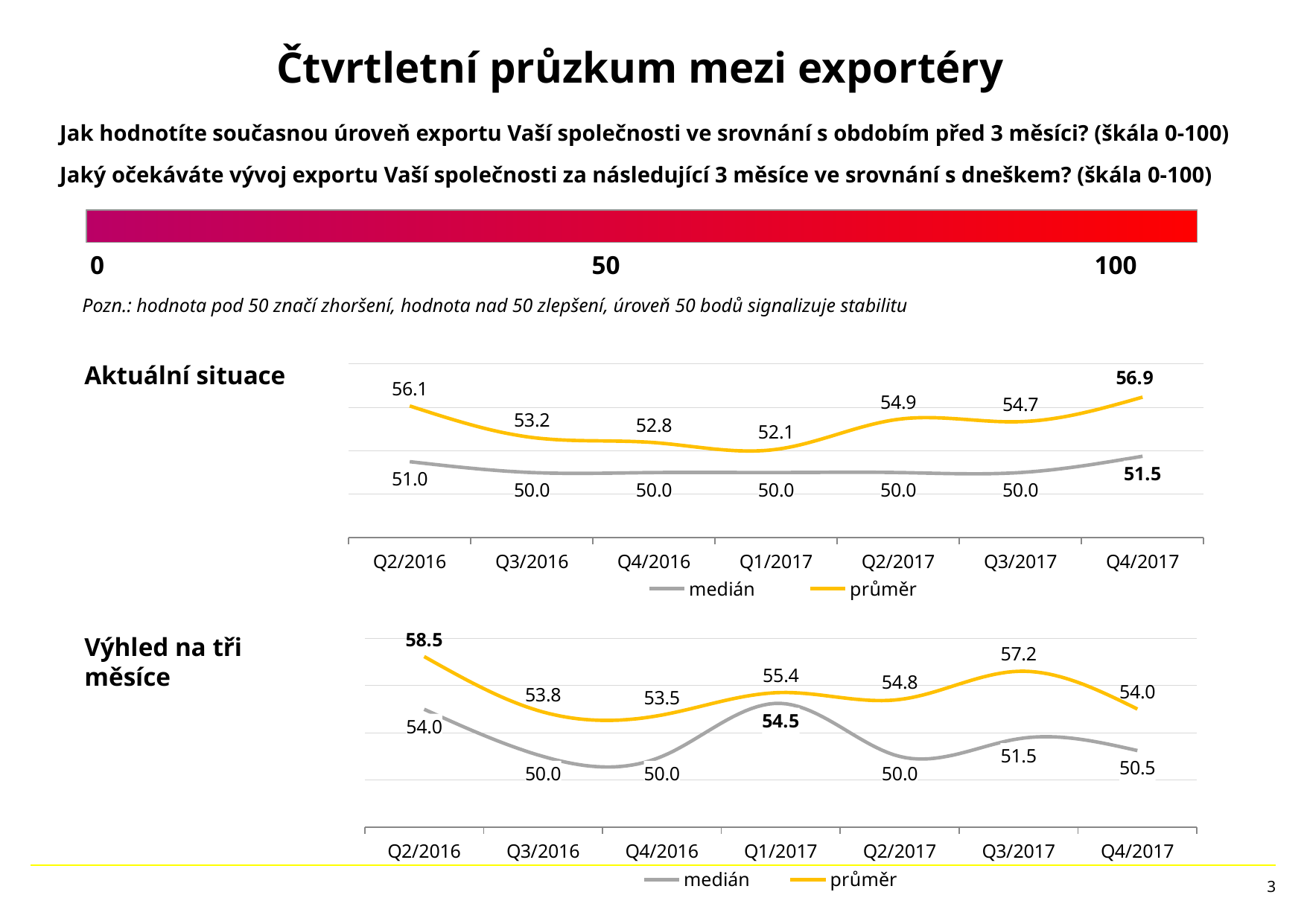
In the 'Aktuální situace' chart, what is the průměr value for Q4/2017? 56.9 In the 'Aktuální situace' chart, in which quarter is the průměr lowest? Q1/2017 In the 'Aktuální situace' chart, how many quarters are shown on the x axis? 7 In the 'Výhled na tři měsíce' chart, what is the medián value for Q1/2017? 54.5 In the 'Výhled na tři měsíce' chart, what is the difference between the průměr and medián values for Q4/2017? 3.5 In the 'Aktuální situace' chart, what is the difference between the průměr values for Q4/2017 and Q1/2017? 4.8 In the 'Výhled na tři měsíce' chart, in which quarter is the průměr highest? Q2/2016 How many series does the legend of the 'Výhled na tři měsíce' chart list? 2 In the 'Výhled na tři měsíce' chart, which is larger, the průměr for Q1/2017 or the průměr for Q2/2017? Q1/2017 In the 'Výhled na tři měsíce' chart, what is the průměr value for Q3/2017? 57.2 In the 'Aktuální situace' chart, what is the medián value for Q2/2016? 51.0 What type of chart is the 'Aktuální situace' chart? Line chart